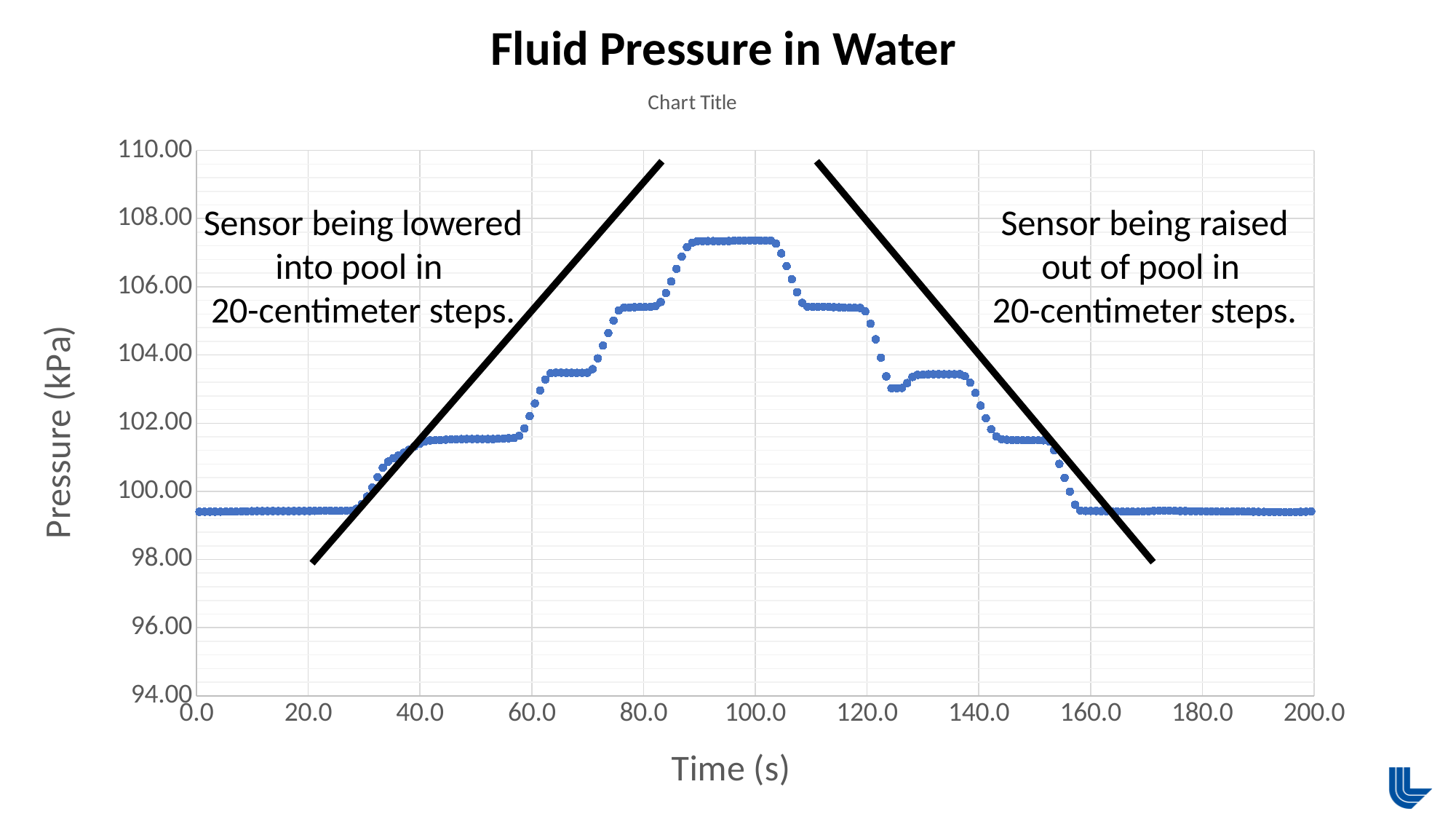
Is the pressure at time 80.0 s greater or less than 104.00 kPa? greater What kind of chart is shown on the slide? scatter chart Is the pressure at time 180.0 s greater or less than 100.00 kPa? less Between 20.0 s and 100.0 s, does the pressure rise or fall? rise Is the pressure at time 100.0 s greater or less than 106.00 kPa? greater Is the pressure at 100.0 s higher or lower than the pressure at 50.0 s? higher Between 100.0 s and 160.0 s, does the pressure rise or fall? fall What is the label of the x axis? Time (s) What is the label of the y axis? Pressure (kPa)